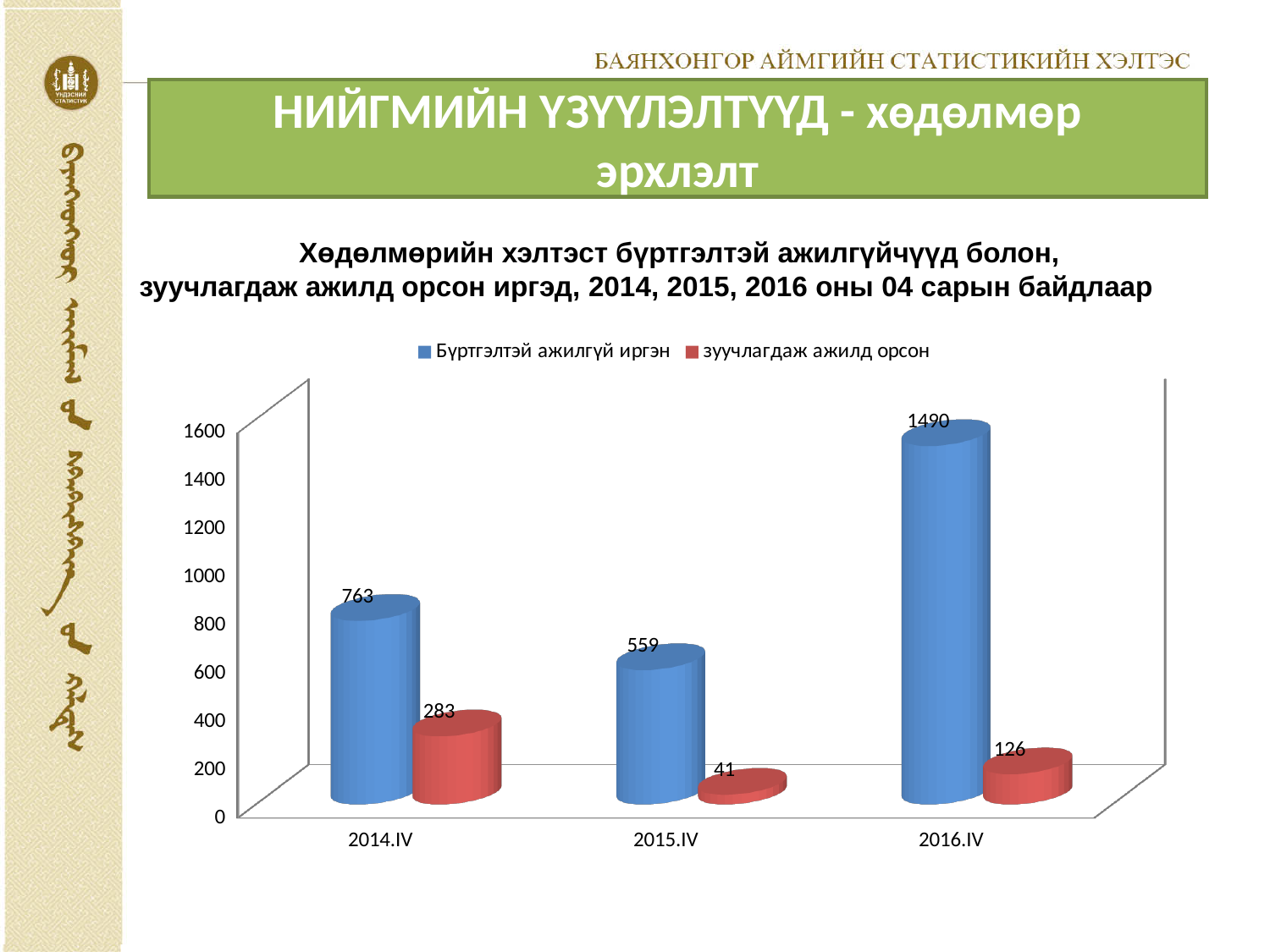
How many periods are shown on the x axis? 3 What is the difference between Бүртгэлтэй ажилгүй иргэн in 2016.IV and 2014.IV? 727 What is the value for Бүртгэлтэй ажилгүй иргэн in 2014.IV? 763 In which period is Бүртгэлтэй ажилгүй иргэн highest? 2016.IV What is the value for зуучлагдаж ажилд орсон in 2015.IV? 41 What kind of chart is shown on the slide? Bar chart What is the value for зуучлагдаж ажилд орсон in 2016.IV? 126 Which is larger: зуучлагдаж ажилд орсон in 2014.IV or in 2016.IV? 2014.IV What is the value for Бүртгэлтэй ажилгүй иргэн in 2016.IV? 1490 How many series does the legend list? 2 Which colour represents зуучлагдаж ажилд орсон in the chart? Red In which period is зуучлагдаж ажилд орсон lowest? 2015.IV